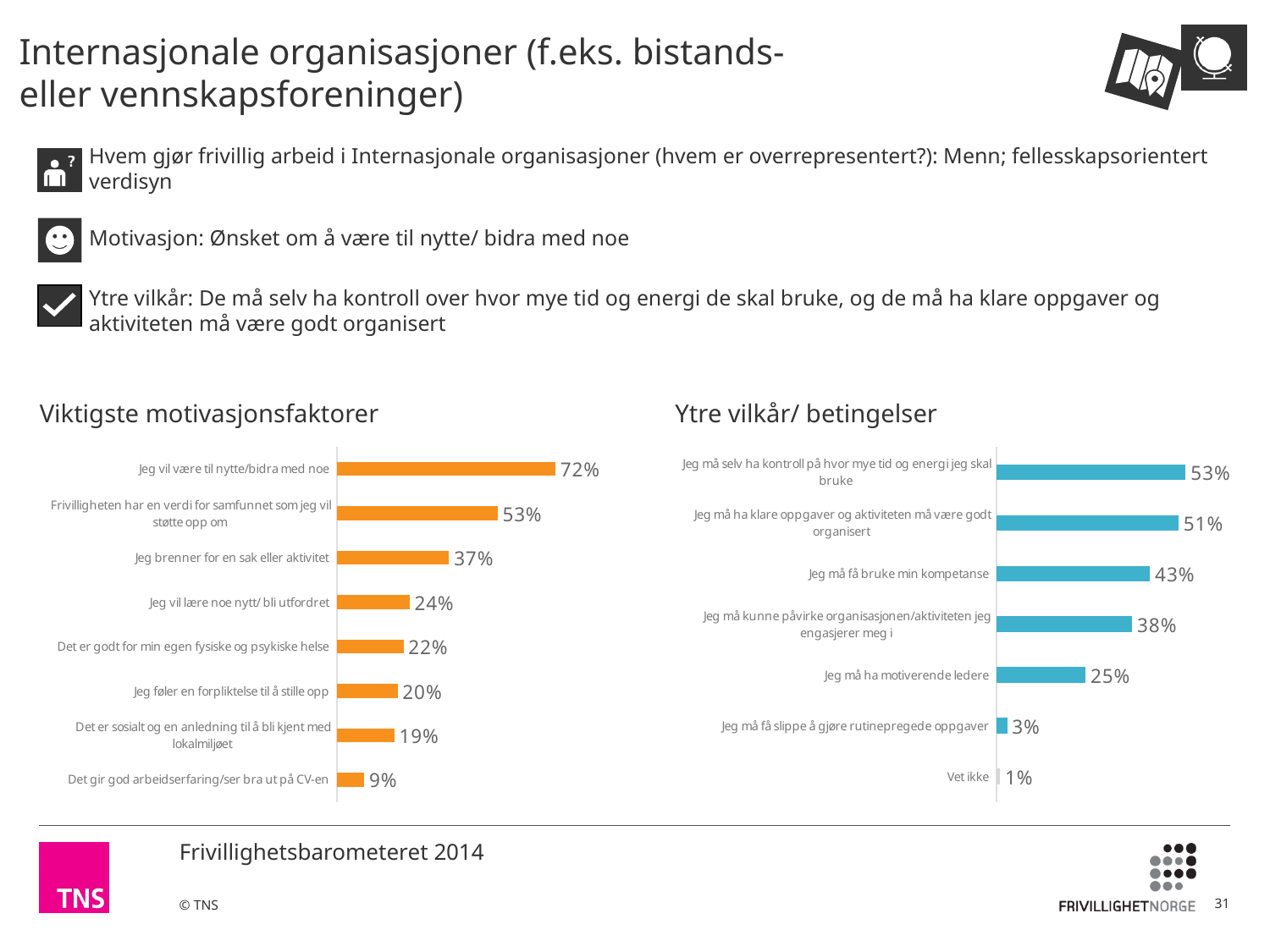
In the 'Viktigste motivasjonsfaktorer' chart, which category has the lowest value? Det gir god arbeidserfaring/ser bra ut på CV-en In the 'Ytre vilkår/ betingelser' chart, how many categories are shown? 7 What colour are the bars in the 'Viktigste motivasjonsfaktorer' chart? Orange In the 'Viktigste motivasjonsfaktorer' chart, what is the value for 'Jeg vil være til nytte/bidra med noe'? 72% In the 'Ytre vilkår/ betingelser' chart, what is the value for 'Jeg må få bruke min kompetanse'? 43% In the 'Ytre vilkår/ betingelser' chart, which category has the highest value? Jeg må selv ha kontroll på hvor mye tid og energi jeg skal bruke In the 'Ytre vilkår/ betingelser' chart, what is the value for 'Vet ikke'? 1% In the 'Viktigste motivasjonsfaktorer' chart, how many categories are shown? 8 In the 'Viktigste motivasjonsfaktorer' chart, which is larger: 'Jeg føler en forpliktelse til å stille opp' or 'Det er sosialt og en anledning til å bli kjent med lokalmiljøet'? Jeg føler en forpliktelse til å stille opp In the 'Viktigste motivasjonsfaktorer' chart, what is the difference between 'Jeg brenner for en sak eller aktivitet' and 'Jeg vil lære noe nytt/ bli utfordret'? 13% In the 'Ytre vilkår/ betingelser' chart, what is the difference between 'Jeg må kunne påvirke organisasjonen/aktiviteten jeg engasjerer meg i' and 'Jeg må ha motiverende ledere'? 13% What type of chart is the 'Ytre vilkår/ betingelser' chart? Bar chart